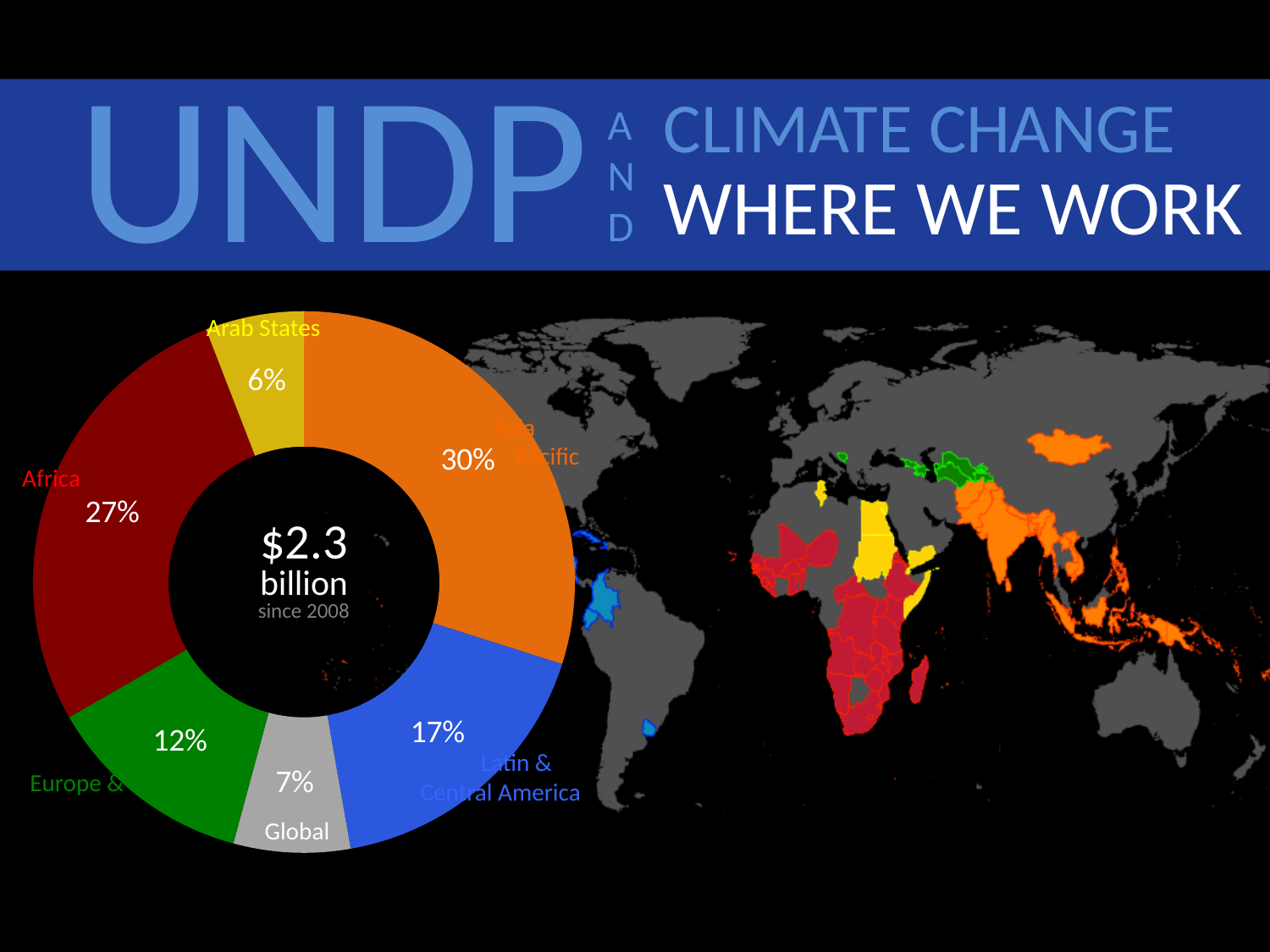
What percentage of the pie chart is labelled Arab States? 6% Which region has the largest share of the pie chart? Asia Pacific What is the difference in percentage points between the Asia Pacific and Africa shares? 3 What percentage of the pie chart is labelled Global? 7% What percentage of the pie chart is labelled Africa? 27% What percentage of the pie chart is labelled Asia Pacific? 30% What percentage of the pie chart is labelled Latin & Central America? 17% Which region has the smallest share of the pie chart? Arab States How many segments does the pie chart have? 6 Which share is larger, Latin & Central America or Global? Latin & Central America What total amount is shown in the centre of the pie chart? $2.3 billion What type of chart is shown on the slide? Pie chart (donut)